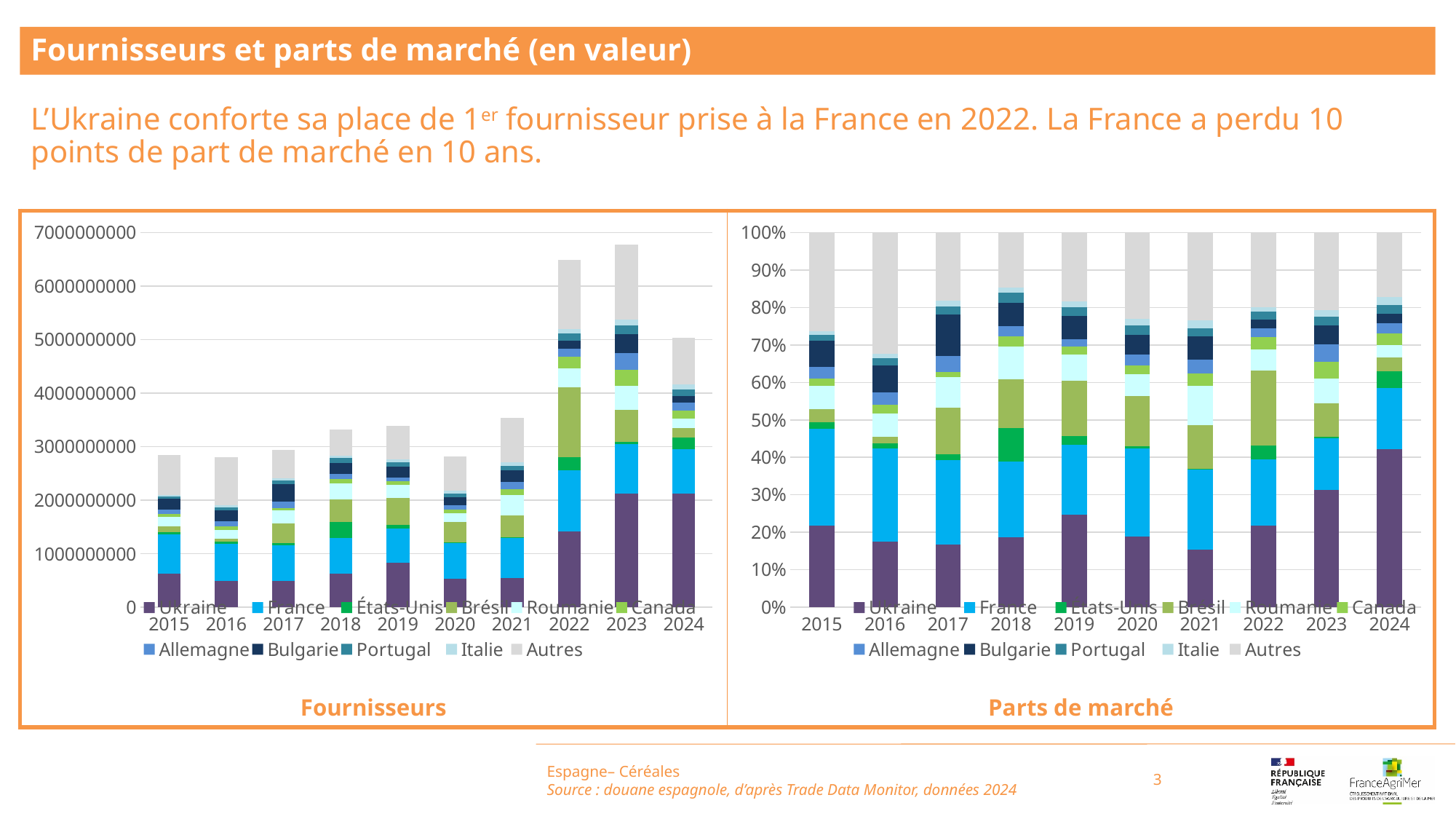
In the 'Fournisseurs' chart, is the total bar for 2015 greater or less than 3000000000? less In the 'Fournisseurs' chart, is the total bar for 2023 greater or less than 6000000000? greater In the 'Fournisseurs' chart, is the total bar for 2024 greater or less than 6000000000? less How many series does the legend of the 'Fournisseurs' chart list? 11 Which series is listed first in the legend of the 'Parts de marché' chart? Ukraine What kind of chart is the 'Fournisseurs' chart on the left? Stacked bar chart How many years are shown on the x axis of the 'Parts de marché' chart? 10 In the 'Fournisseurs' chart, which year has the tallest total bar? 2023 In the 'Parts de marché' chart, is the Ukraine share larger in 2021 or in 2024? 2024 In the 'Parts de marché' chart, does the Ukraine share rise or fall from 2021 to 2024? Rise